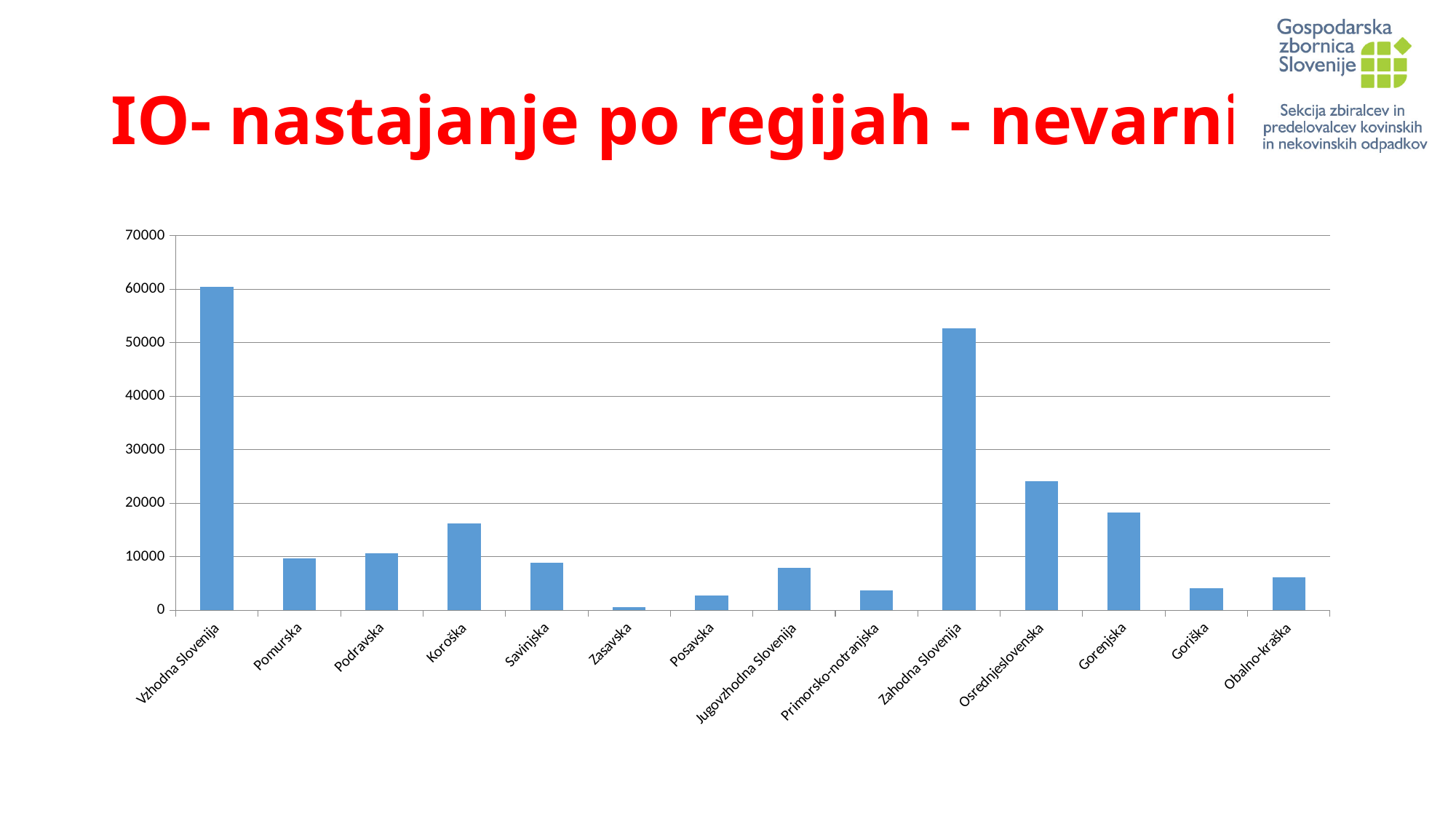
Is the value for Savinjska greater or less than 10000? less Which is larger, the value for Osrednjeslovenska or the value for Gorenjska? Osrednjeslovenska Is the value for Koroška greater or less than 20000? less What kind of chart is shown on the slide? bar chart Is the value for Goriška greater or less than 10000? less Which region has the highest value on the chart? Vzhodna Slovenija Which is larger, the value for Vzhodna Slovenija or the value for Zahodna Slovenija? Vzhodna Slovenija Which region has the lowest value on the chart? Zasavska What is the title of the slide containing the chart? IO- nastajanje po regijah - nevarni How many regions (categories) are plotted on the chart? 14